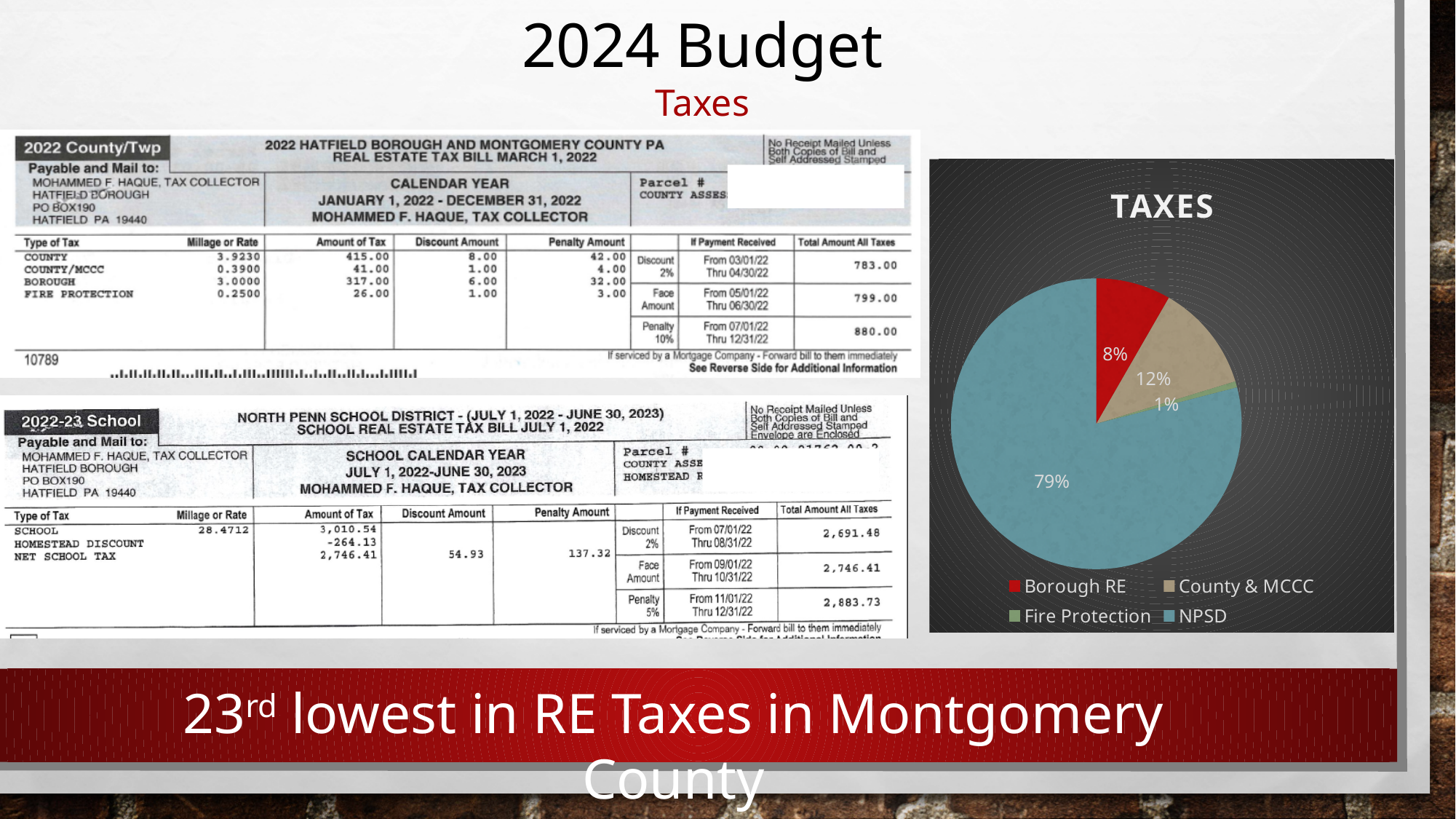
What kind of chart is the TAXES chart on the slide? pie chart What colour is the NPSD slice in the TAXES pie chart? teal blue Which slice of the TAXES pie chart is the largest? NPSD In the TAXES pie chart, what share does NPSD have? 79% In the TAXES pie chart, what share does Borough RE have? 8% In the TAXES pie chart, what share does Fire Protection have? 1% In the TAXES pie chart, what is the difference between the NPSD share and the County & MCCC share? 67% How many slices does the TAXES pie chart have? 4 In the TAXES pie chart, which is larger: Borough RE or County & MCCC? County & MCCC Which slice of the TAXES pie chart is the smallest? Fire Protection In the TAXES pie chart, what is the difference between the County & MCCC share and the Borough RE share? 4%